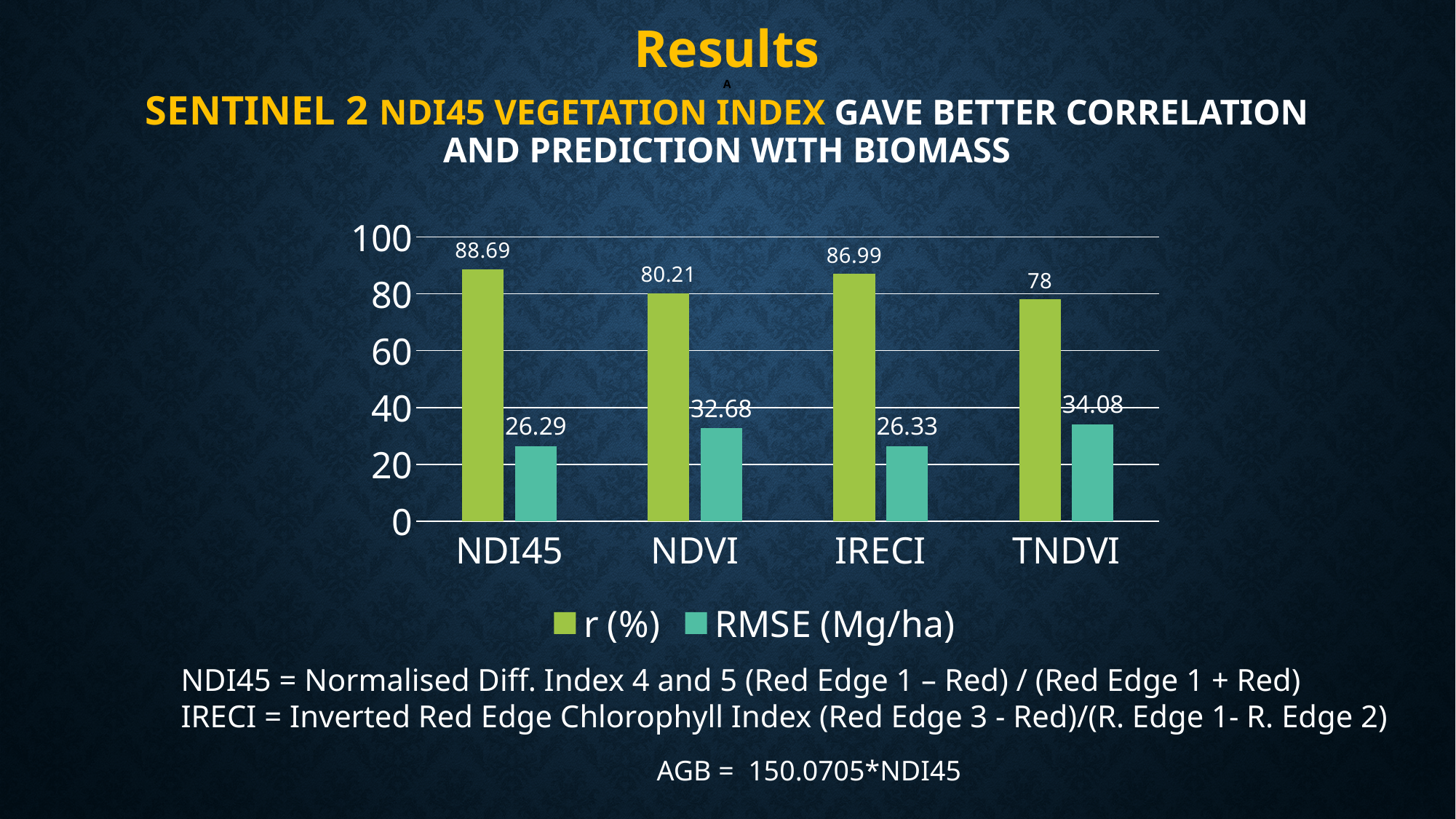
What kind of chart is shown on the slide? Bar chart What is the RMSE (Mg/ha) value for NDVI? 32.68 What is the r (%) value for NDI45? 88.69 Which vegetation index has the lowest r (%) value? TNDVI Which vegetation index has the highest r (%) value? NDI45 How many vegetation indices are shown on the x axis? 4 What is the difference between the r (%) values of NDI45 and TNDVI? 10.69 Which colour represents the RMSE (Mg/ha) series in the legend? Teal Which vegetation index has the highest RMSE (Mg/ha)? TNDVI How many series does the legend list? 2 Which is larger, the r (%) value for NDVI or for IRECI? IRECI What is the RMSE (Mg/ha) value for TNDVI? 34.08